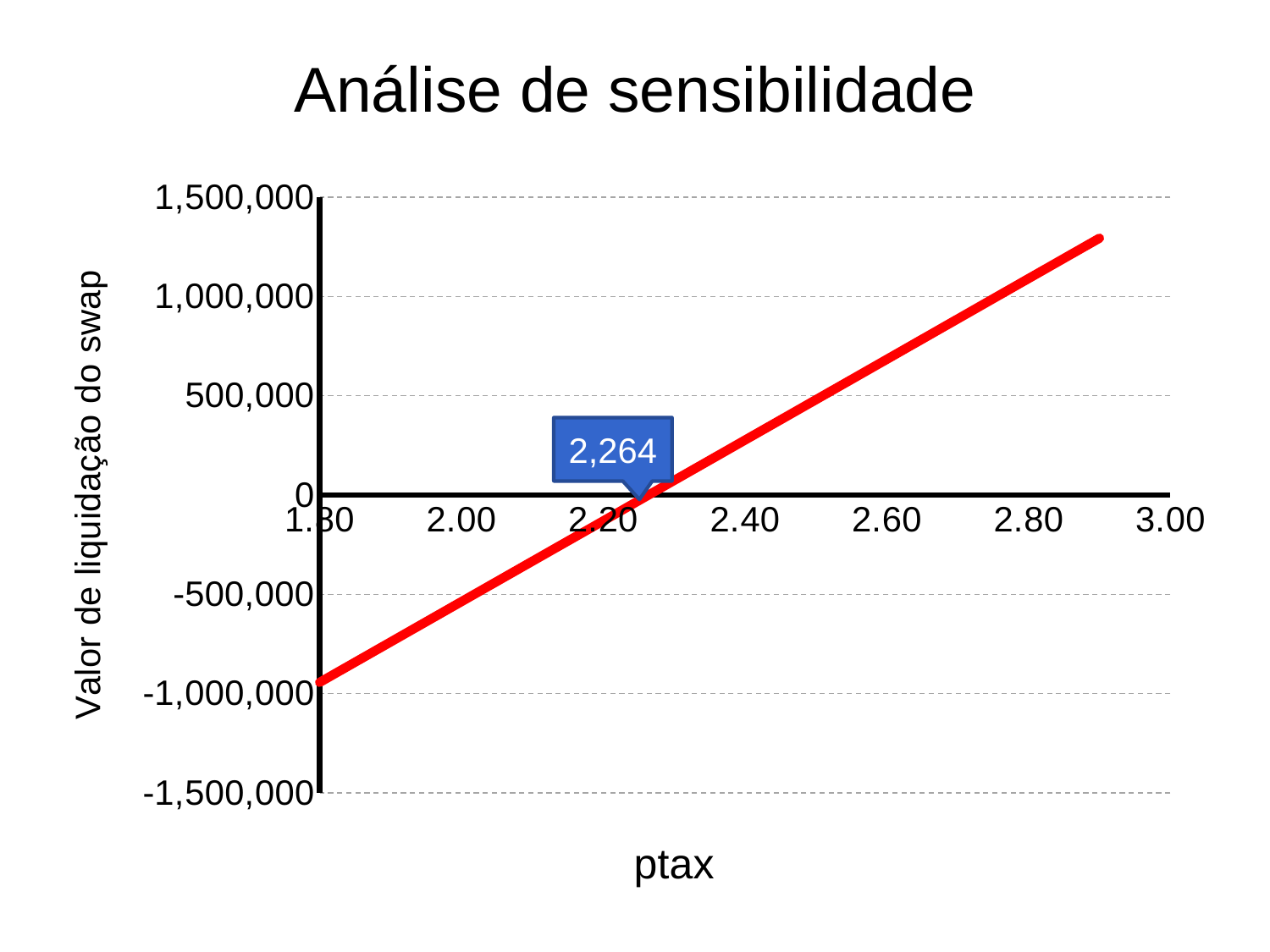
Does the swap liquidation value rise or fall as ptax increases along the x axis? rise What kind of chart is shown on the slide? line chart What is the label of the vertical axis? Valor de liquidação do swap Is the swap liquidation value at ptax 2.00 greater or less than 0? less Is the swap liquidation value at ptax 1.80 greater or less than -500,000? less What value is shown in the callout label on the chart? 2,264 Is the swap liquidation value at ptax 2.80 greater or less than 500,000? greater According to the callout, at what ptax does the swap liquidation value cross zero? 2,264 Which ptax value gives the larger swap liquidation value, 2.00 or 2.80? 2.80 What is the title of the chart? Análise de sensibilidade